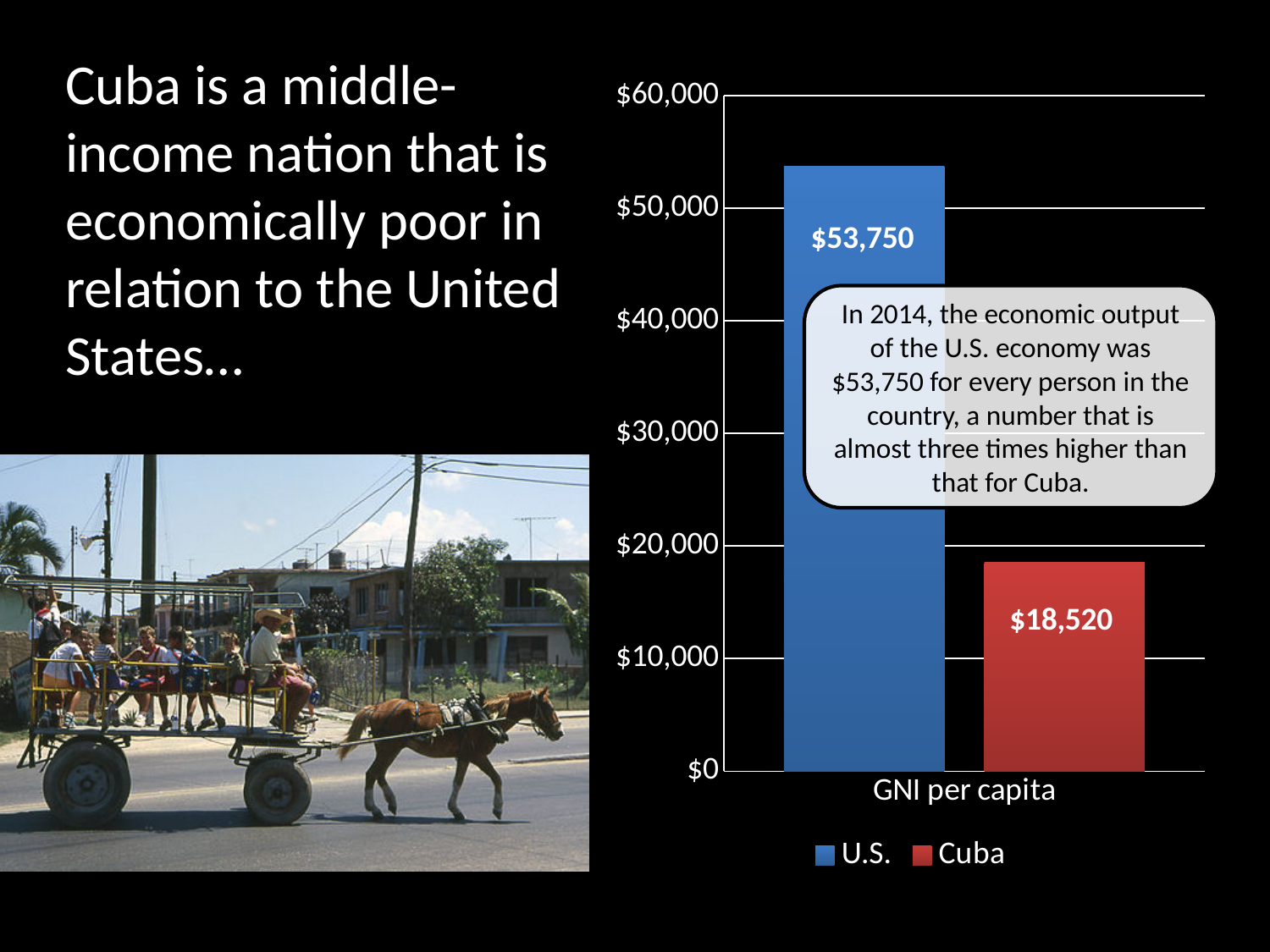
Which colour represents Cuba in the chart? red What is the difference between the U.S. and Cuba GNI per capita values? $35,230 What is the category label on the x axis of the chart? GNI per capita What is the highest value shown on the y axis of the chart? $60,000 Which series has the lowest GNI per capita on the chart? Cuba Which series has the higher GNI per capita, U.S. or Cuba? U.S. What kind of chart is shown on the slide? bar chart How many series does the legend list? 2 What is the GNI per capita value shown for the U.S.? $53,750 What is the GNI per capita value shown for Cuba? $18,520 Is the GNI per capita for Cuba greater or less than $20,000? less Is the GNI per capita for the U.S. greater or less than $50,000? greater